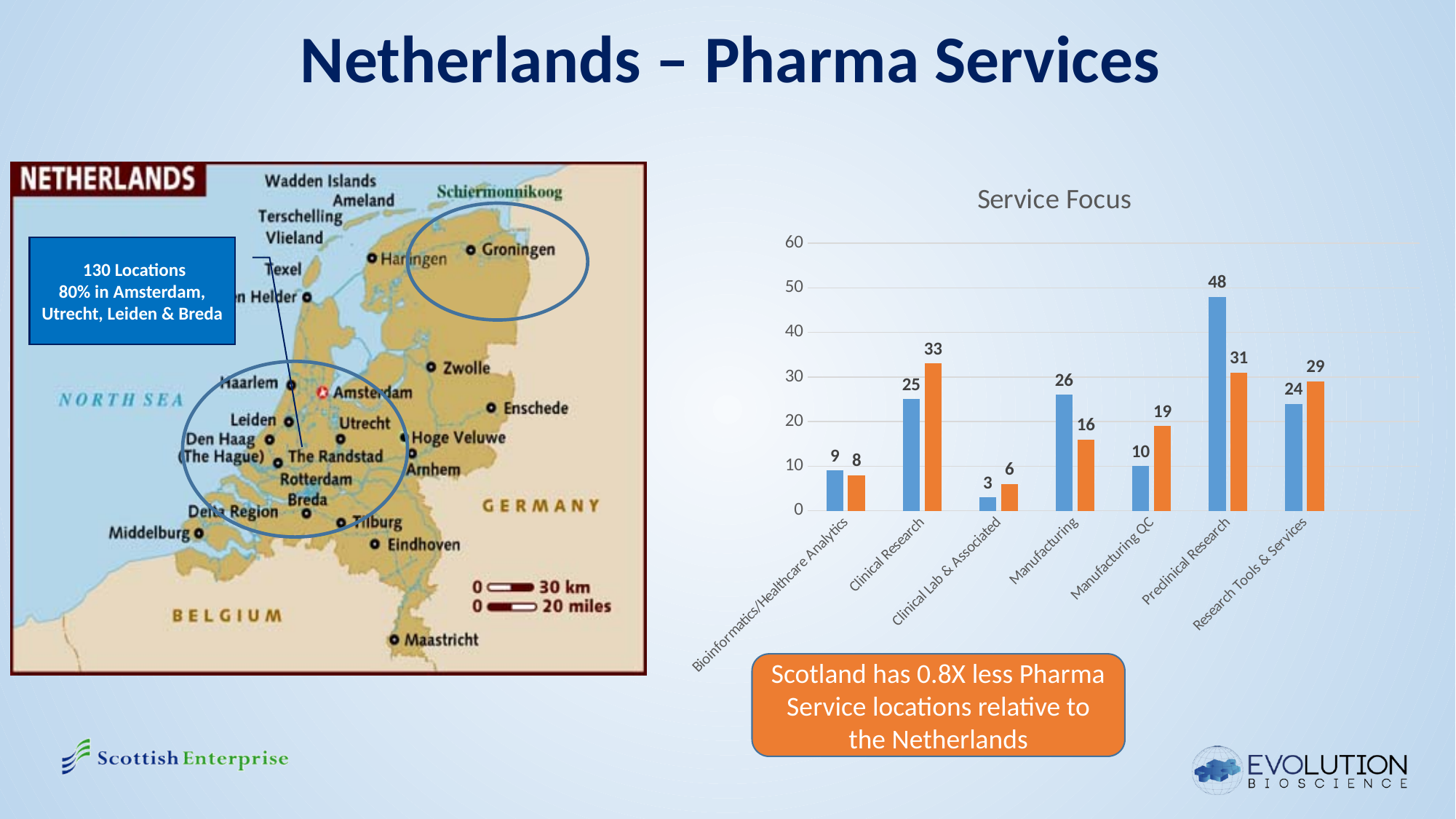
What is the difference between the blue and orange bars for Preclinical Research? 17 Is the value of the orange bar for Research Tools & Services greater or less than 20? greater For Manufacturing, which is larger, the blue bar or the orange bar? the blue bar Which category has the lowest orange bar? Clinical Lab & Associated What is the value of the orange bar for Clinical Research? 33 What is the title of the chart? Service Focus What is the difference between the orange bars for Manufacturing QC and Manufacturing? 3 Which category has the highest blue bar? Preclinical Research What type of chart is shown on the slide? bar chart What is the value of the blue bar for Manufacturing QC? 10 How many categories are shown on the x axis of the chart? 7 What is the value of the blue bar for Preclinical Research? 48